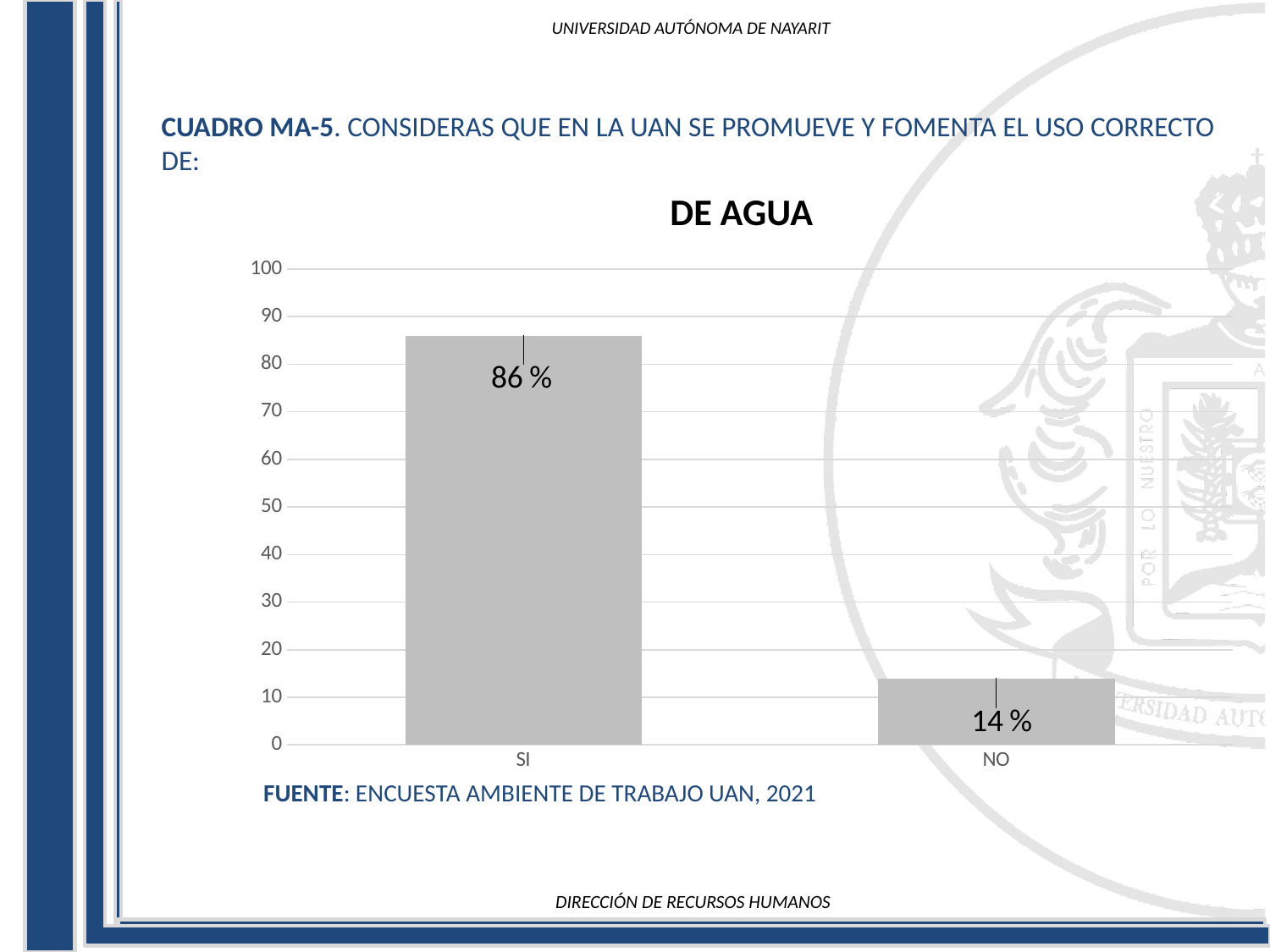
Which category has the lowest value? NO Which category has the highest value? SI What is the value for NO? 14 % What is the source cited below the chart? ENCUESTA AMBIENTE DE TRABAJO UAN, 2021 What kind of chart is shown on the slide? bar chart What is the difference between the values for SI and NO? 72 % Is the value for NO greater or less than 20? less How many categories are shown on the x axis? 2 Is the value for SI greater or less than 80? greater What is the value for SI? 86 % Which is larger, the value for SI or the value for NO? SI What is the title of the chart? DE AGUA